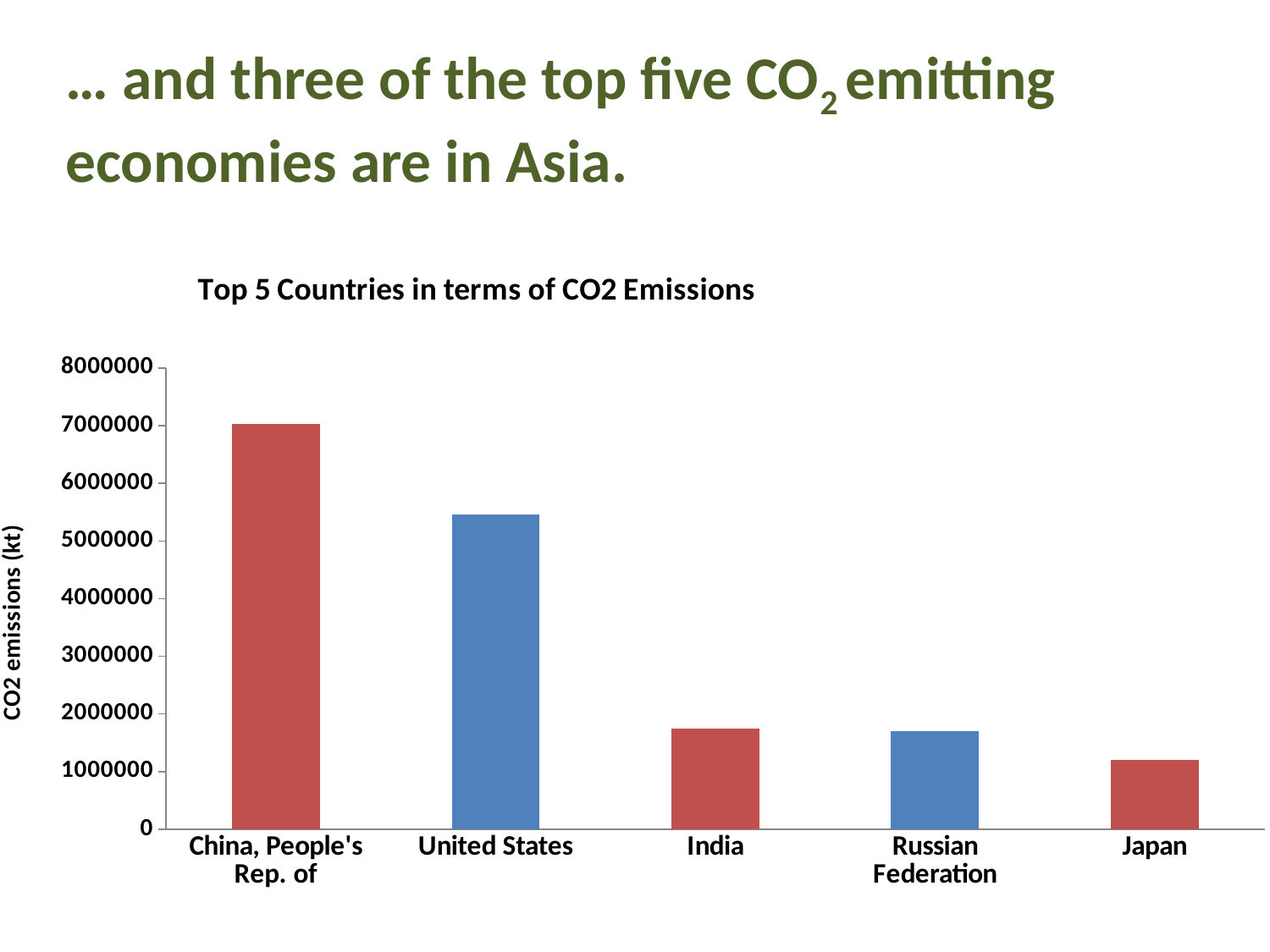
Do the values rise or fall from left to right across the countries? fall What is the title of the chart? Top 5 Countries in terms of CO2 Emissions How many countries are shown in the chart? 5 Which country has the highest CO2 emissions in the chart? China, People's Rep. of Is the value for Japan greater or less than 1000000? greater Which has higher CO2 emissions, United States or India? United States Which country has the lowest CO2 emissions in the chart? Japan What kind of chart is shown on the slide? bar chart Is the value for United States greater or less than 6000000? less What is the label on the vertical axis of the chart? CO2 emissions (kt) Which has higher CO2 emissions, China, People's Rep. of or United States? China, People's Rep. of